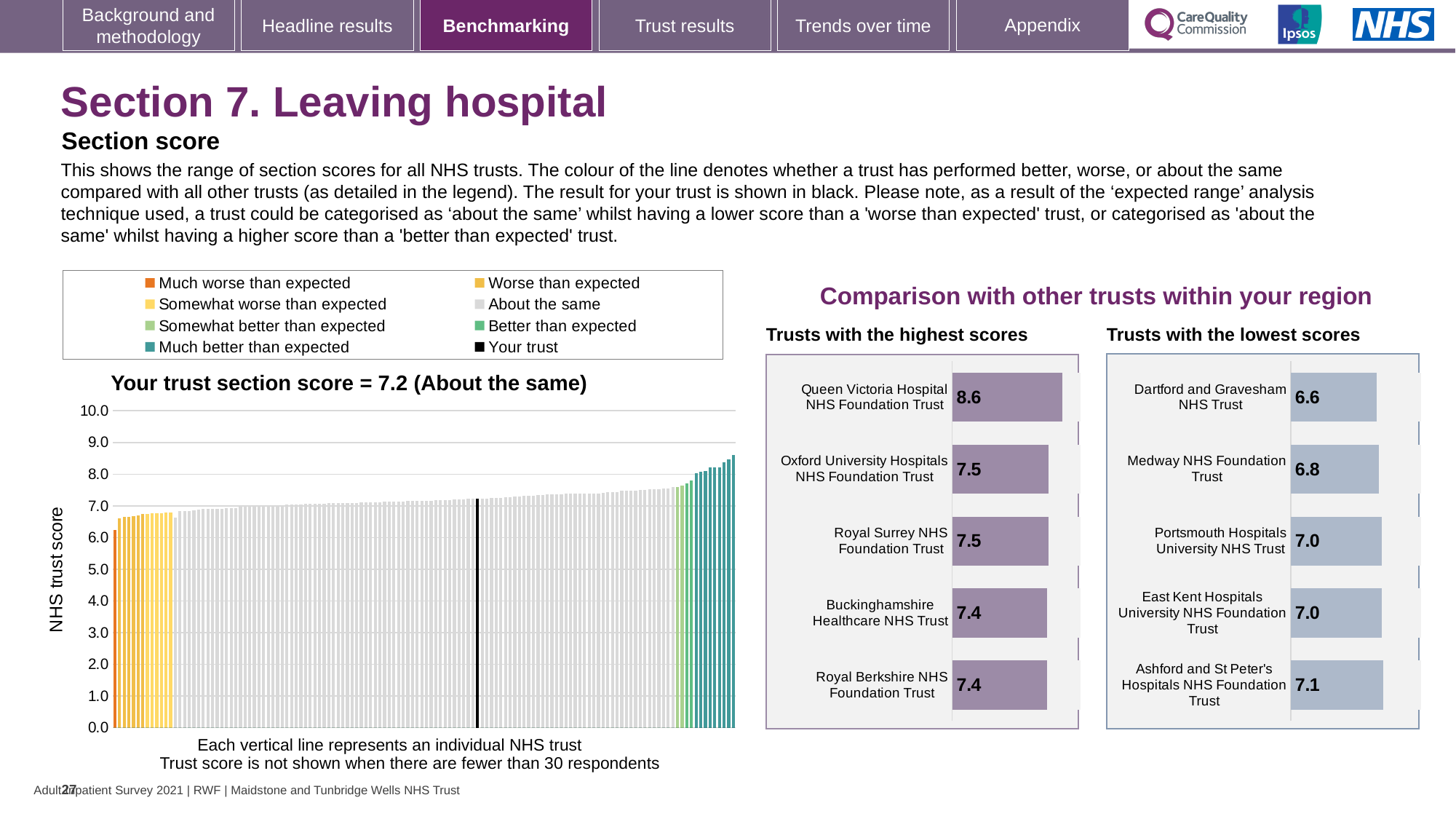
How many trusts are shown in the 'Trusts with the lowest scores' chart? 5 In the 'Trusts with the highest scores' chart, what is the difference between the scores of Queen Victoria Hospital NHS Foundation Trust and Oxford University Hospitals NHS Foundation Trust? 1.1 In the main chart of all NHS trusts, do the trust scores rise or fall from left to right? rise In the 'Trusts with the lowest scores' chart, what is the score for Medway NHS Foundation Trust? 6.8 In the 'Trusts with the lowest scores' chart, which has the higher score: Medway NHS Foundation Trust or Portsmouth Hospitals University NHS Trust? Portsmouth Hospitals University NHS Trust In the 'Trusts with the lowest scores' chart, what is the difference between the scores of Ashford and St Peter's Hospitals NHS Foundation Trust and Dartford and Gravesham NHS Trust? 0.5 In the 'Trusts with the highest scores' chart, which trust has the highest score? Queen Victoria Hospital NHS Foundation Trust In the 'Trusts with the highest scores' chart, what is the score for Buckinghamshire Healthcare NHS Trust? 7.4 In the 'Trusts with the lowest scores' chart, which trust has the lowest score? Dartford and Gravesham NHS Trust How many entries does the legend of the main chart of all NHS trusts list? 8 In the 'Trusts with the highest scores' chart, what is the score for Queen Victoria Hospital NHS Foundation Trust? 8.6 In the main chart of all NHS trusts, what is the section score for your trust? 7.2